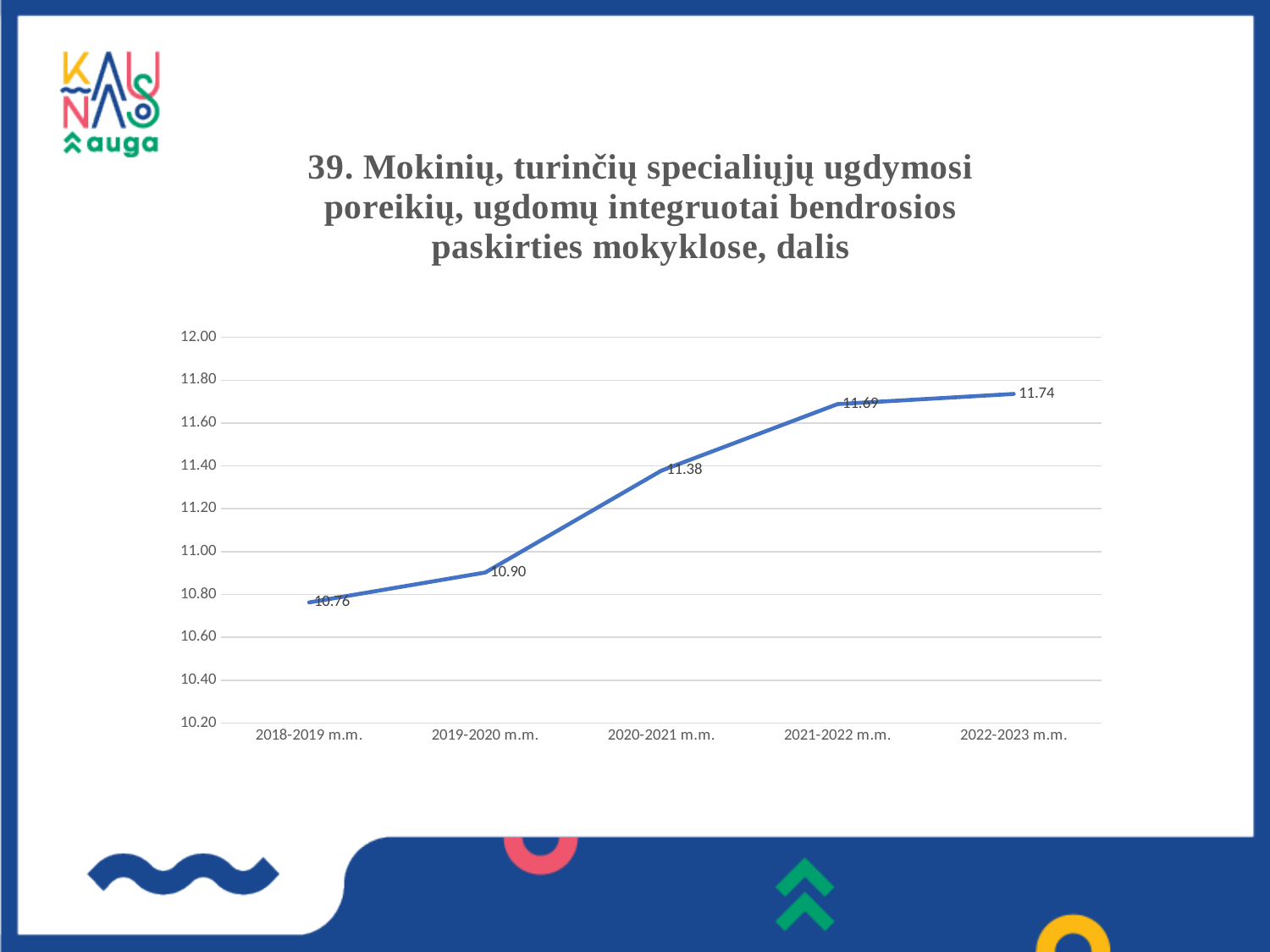
How many school years are plotted on the chart? 5 Which is larger, the value for 2019-2020 m.m. or the value for 2020-2021 m.m.? 2020-2021 m.m. What is the difference between the values for 2020-2021 m.m. and 2019-2020 m.m.? 0.48 What is the difference between the values for 2022-2023 m.m. and 2018-2019 m.m.? 0.98 What is the value for 2018-2019 m.m.? 10.76 Is the value for 2019-2020 m.m. greater or less than 11.00? less Which school year has the lowest value? 2018-2019 m.m. What is the value for 2022-2023 m.m.? 11.74 What kind of chart is shown on the slide? line chart What is the value for 2020-2021 m.m.? 11.38 Which school year has the highest value? 2022-2023 m.m. What is the value for 2021-2022 m.m.? 11.69